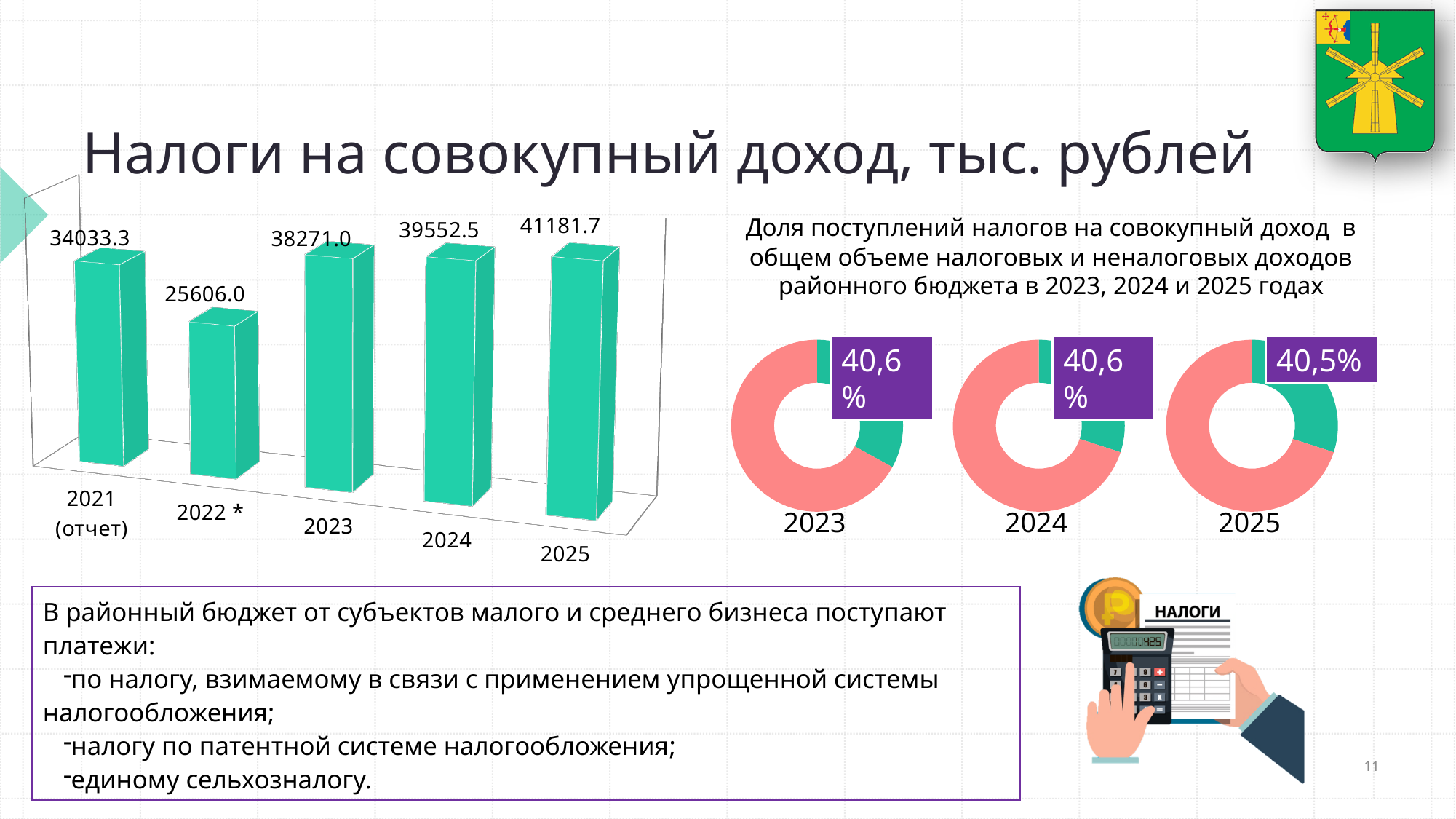
On the bar chart, do the values rise or fall from 2022 * to 2025? rise On the bar chart, what is the difference between the values for 2025 and 2021 (отчет)? 7148.4 On the bar chart, which year has the lowest value? 2022 * On the bar chart, which is larger: the value for 2024 or the value for 2023? 2024 On the bar chart, what is the value for 2021 (отчет)? 34033.3 On the bar chart, what is the difference between the values for 2023 and 2022 *? 12665.0 On the bar chart, what is the value for 2022 *? 25606.0 What kind of chart is the chart on the left of the slide? bar chart On the bar chart, what is the value for 2025? 41181.7 How many bars are shown on the bar chart? 5 On the bar chart, which year has the highest value? 2025 On the donut chart for 2025, what share is shown in the label? 40,5%